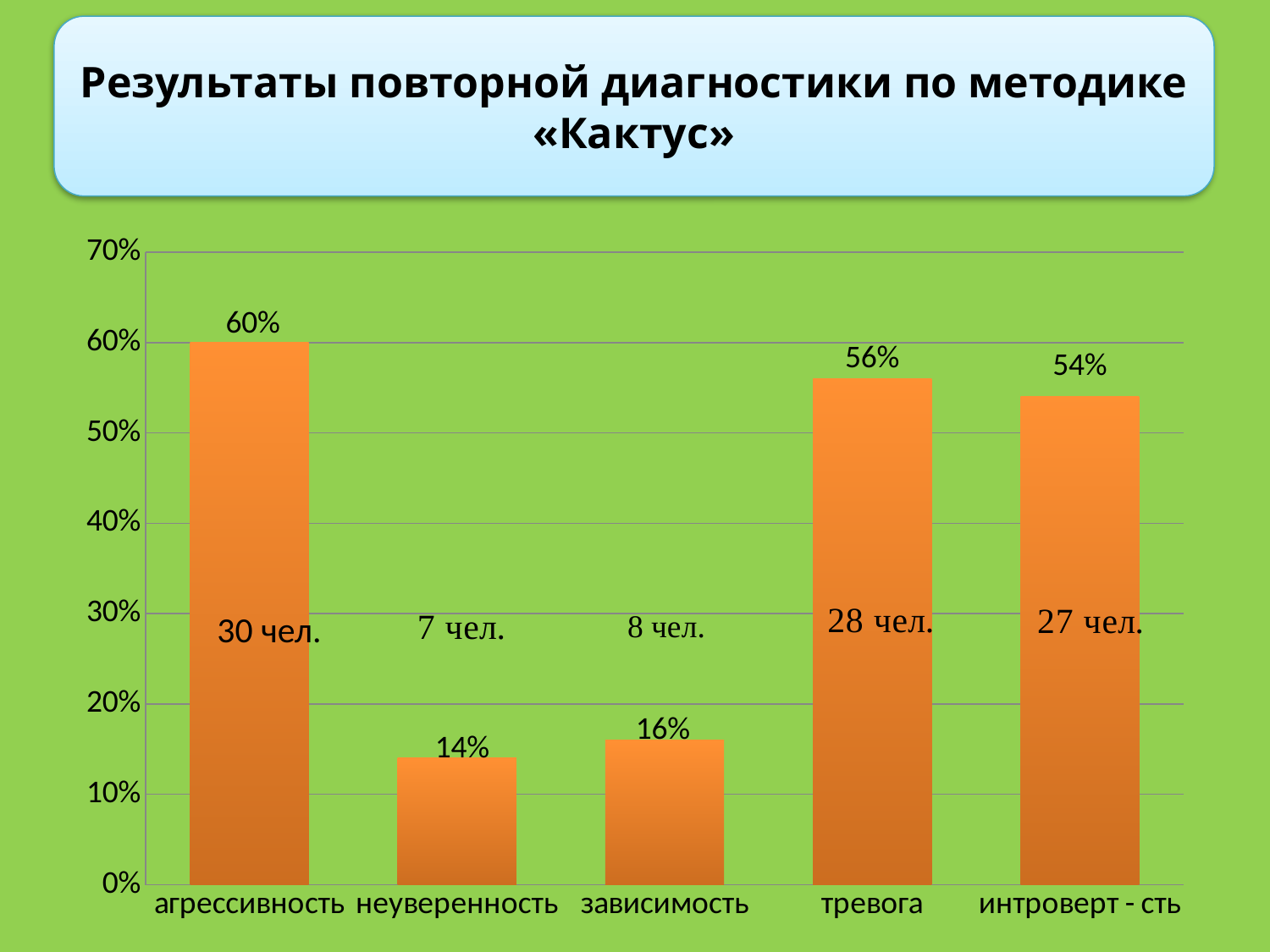
What kind of chart is shown on the slide? bar chart Which category has the highest value? агрессивность What is the difference between the values for агрессивность and интроверт - сть? 6% Which category has the lowest value? неуверенность What is the value for неуверенность? 14% Is the value for тревога greater or less than 50%? greater How many people (чел.) are indicated for зависимость? 8 чел. How many categories are shown on the x axis? 5 What is the value for тревога? 56% What is the title of the slide? Результаты повторной диагностики по методике «Кактус» What is the value for агрессивность? 60% Which is larger, the value for зависимость or the value for неуверенность? зависимость